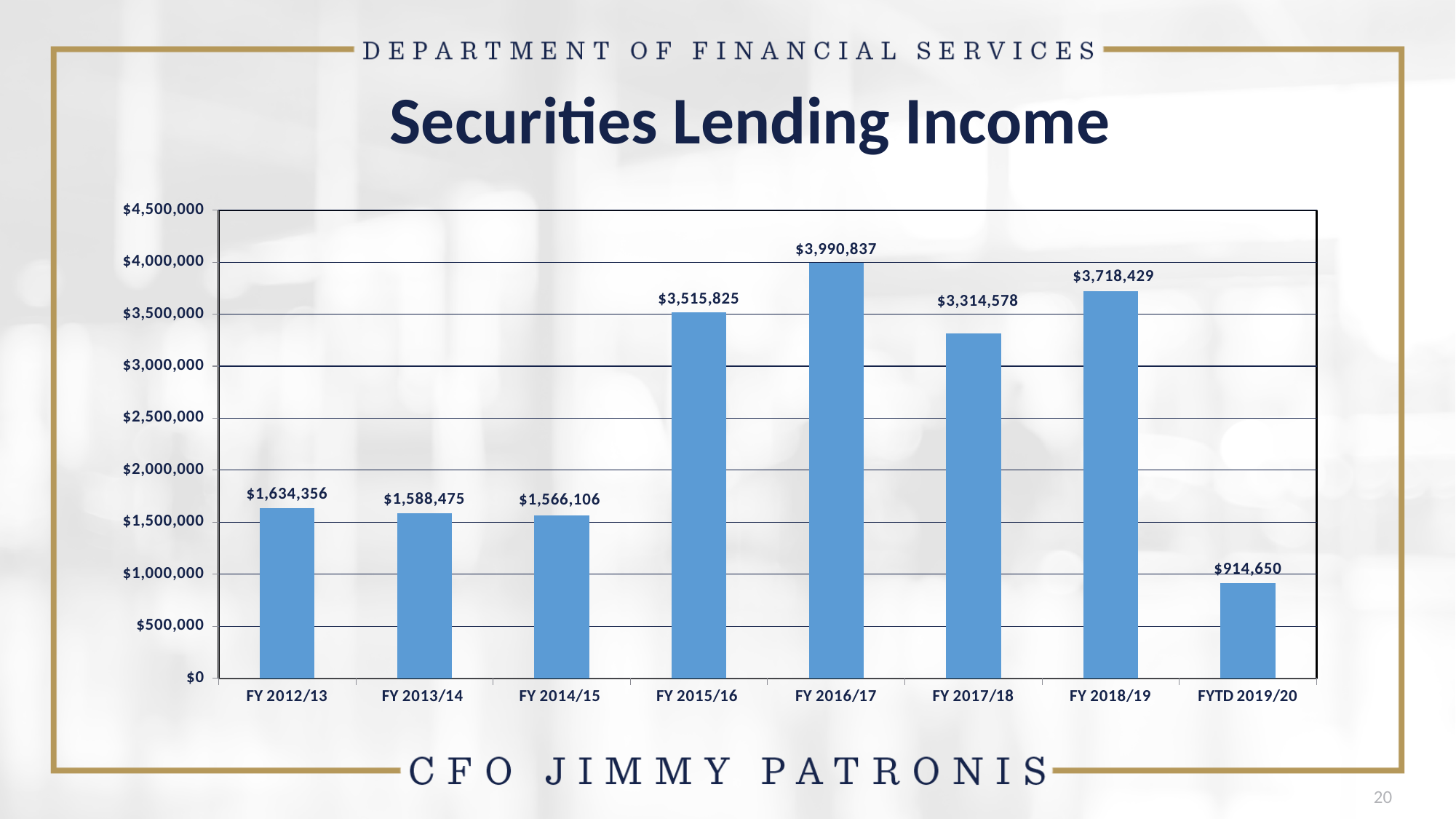
What is the securities lending income for FYTD 2019/20? $914,650 What type of chart is used to show securities lending income? bar chart Is the securities lending income for FY 2017/18 greater or less than $3,000,000? greater Which is larger, the securities lending income for FY 2018/19 or FY 2015/16? FY 2018/19 What is the title of the chart on the slide? Securities Lending Income How many fiscal periods are shown on the chart? 8 What is the securities lending income for FY 2016/17? $3,990,837 What is the difference in securities lending income between FY 2018/19 and FY 2017/18? $403,851 What is the difference in securities lending income between FY 2016/17 and FY 2015/16? $475,012 What is the securities lending income for FY 2014/15? $1,566,106 Which fiscal year has the highest securities lending income? FY 2016/17 Which period has the lowest securities lending income? FYTD 2019/20